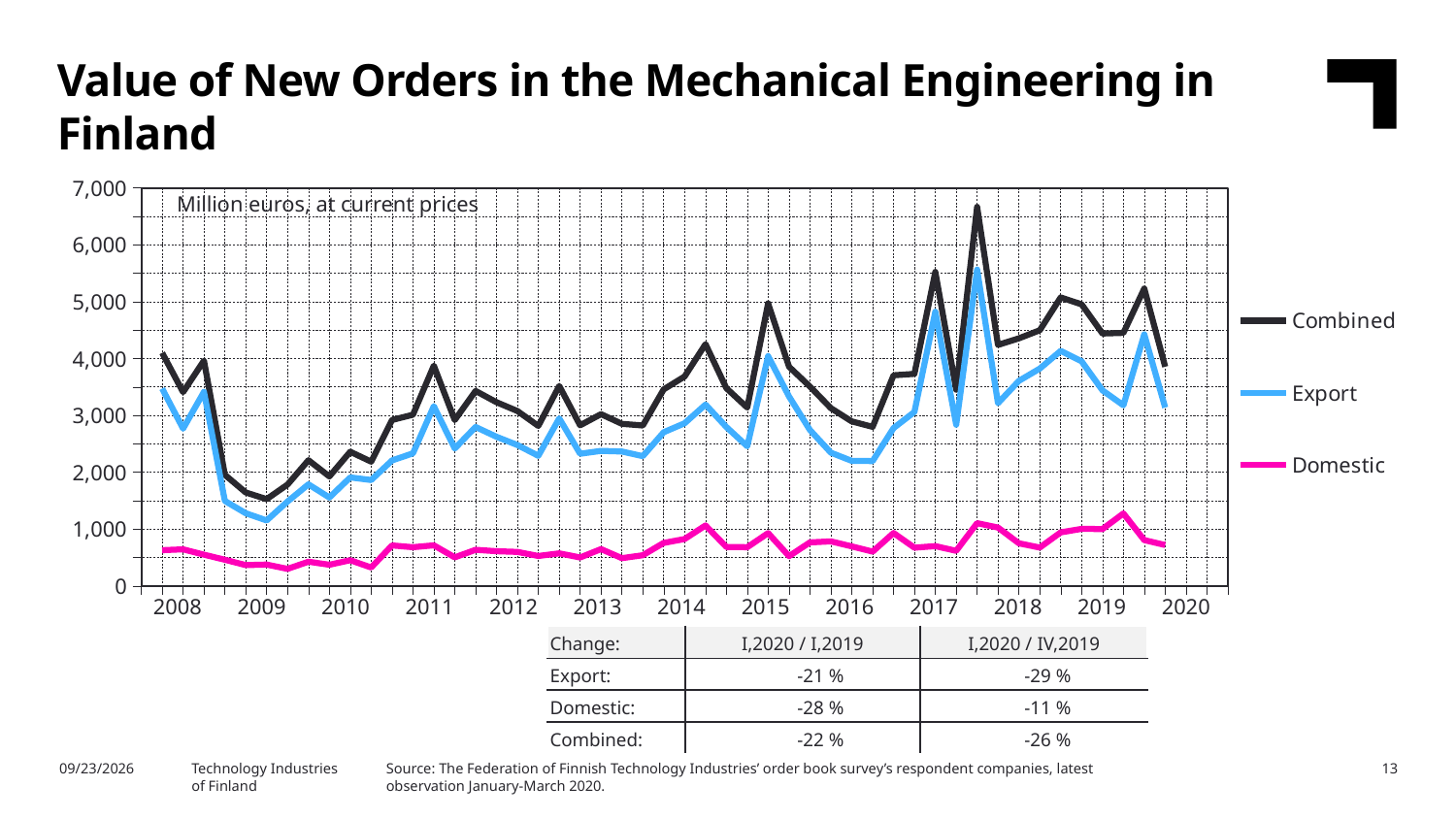
Which series are listed in the chart legend? Combined, Export, Domestic How many series does the chart legend list? 3 Is the Domestic series ever greater or less than 2,000 over the whole period? less Which series has the highest values throughout the chart? Combined What unit note is printed inside the chart area? Million euros, at current prices Is the Export value at the start of 2008 greater or less than 3,000? greater How many years are labeled on the x axis? 13 Do the Combined values rise or fall from 2008 to 2009? fall What kind of chart is shown on the slide? line chart Is the peak value of the Combined series in 2017 greater or less than 6,000? greater Which series has the lowest values throughout the chart? Domestic Which series is larger in 2015, Export or Domestic? Export